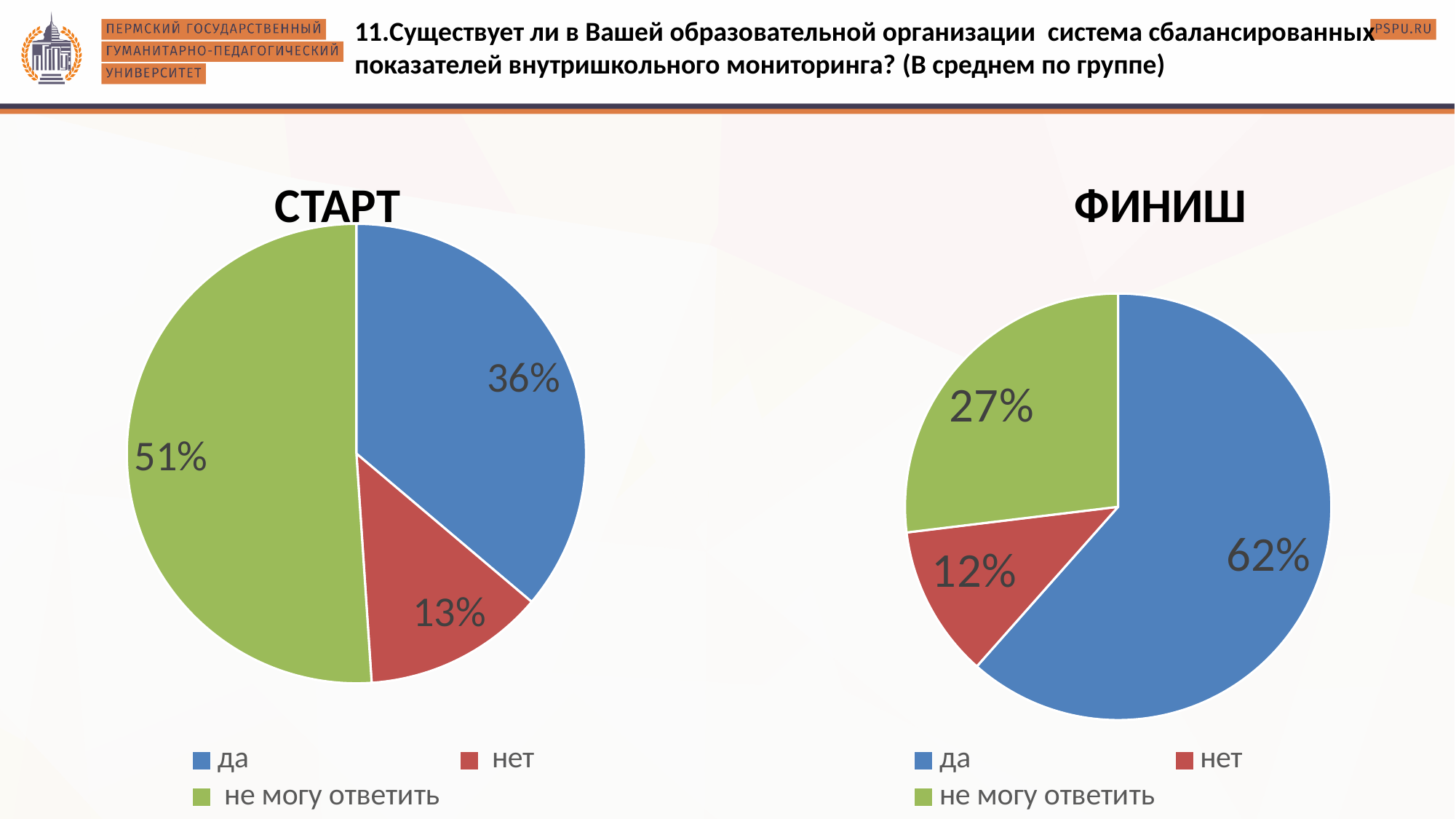
In the СТАРТ chart, which answer has the smallest share? нет What is the difference between the "да" share in the ФИНИШ chart and the "да" share in the СТАРТ chart? 26% In the СТАРТ chart, what share of respondents answered "не могу ответить"? 51% In the СТАРТ chart, which answer has the largest share? не могу ответить In the ФИНИШ chart, which is larger: the share for "да" or the share for "не могу ответить"? да In the ФИНИШ chart, what colour is the slice for "не могу ответить"? Green In the ФИНИШ chart, what share of respondents answered "нет"? 12% How many slices does the ФИНИШ pie chart have? 3 In the ФИНИШ chart, what share of respondents answered "да"? 62% In the ФИНИШ chart, which answer has the smallest share? нет What type of chart is the СТАРТ chart? Pie chart In the СТАРТ chart, what share of respondents answered "да"? 36%